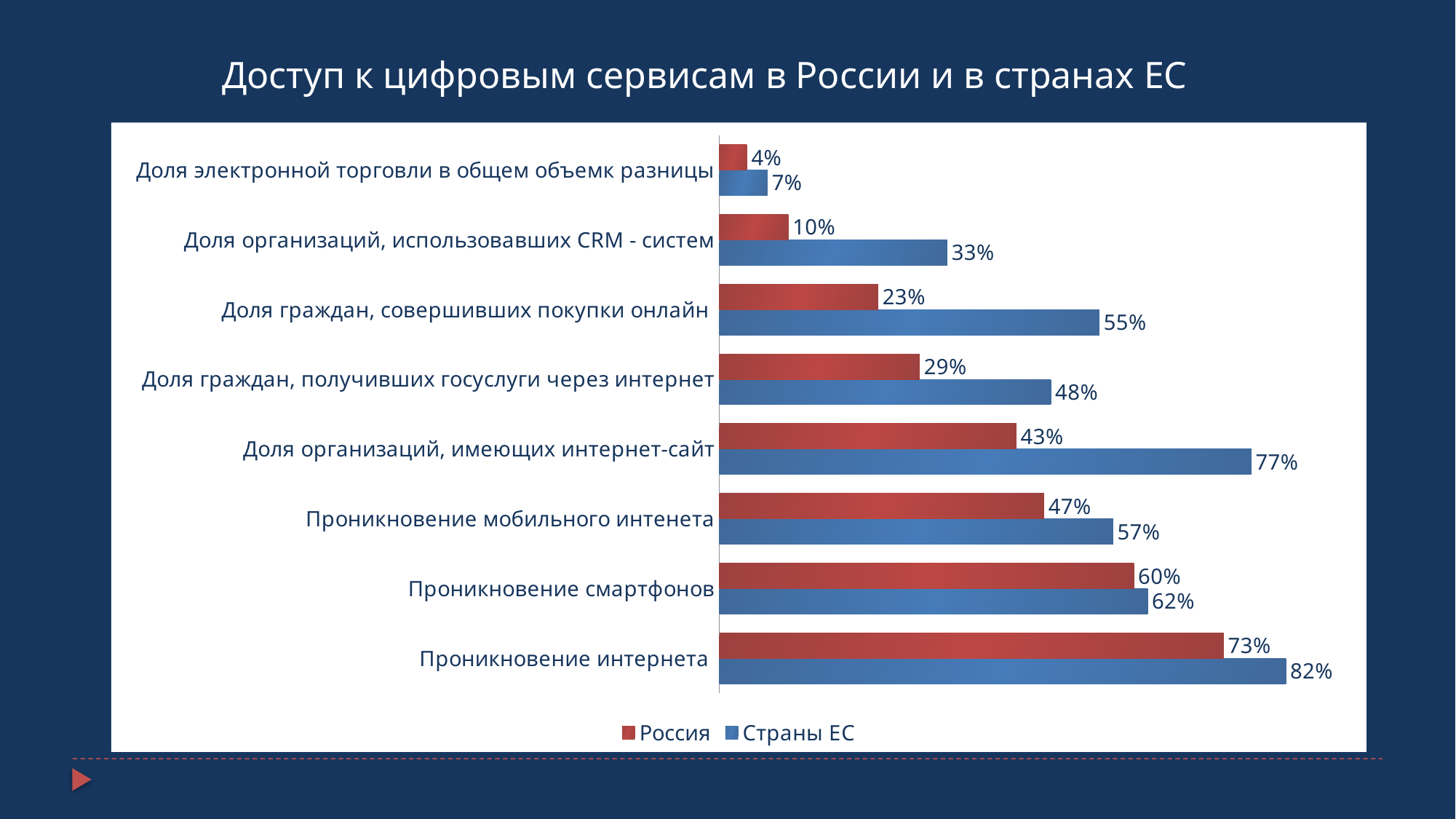
Which category has the highest value for Страны ЕС? Проникновение интернета What kind of chart is shown on the slide? Bar chart What is the value for Россия in the category Проникновение интернета? 73% What is the value for Страны ЕС in the category Доля организаций, имеющих интернет-сайт? 77% Which category has the lowest value for Россия? Доля электронной торговли в общем объемк разницы What is the value for Страны ЕС in the category Доля организаций, использовавших CRM - систем? 33% Which colour represents the series Россия in the chart? Red What is the title of the slide? Доступ к цифровым сервисам в России и в странах ЕС What is the difference between Страны ЕС and Россия in the category Доля граждан, совершивших покупки онлайн? 32% How many categories are shown in the chart? 8 Which is larger in the category Доля граждан, получивших госуслуги через интернет: Россия or Страны ЕС? Страны ЕС How many series does the legend list? 2